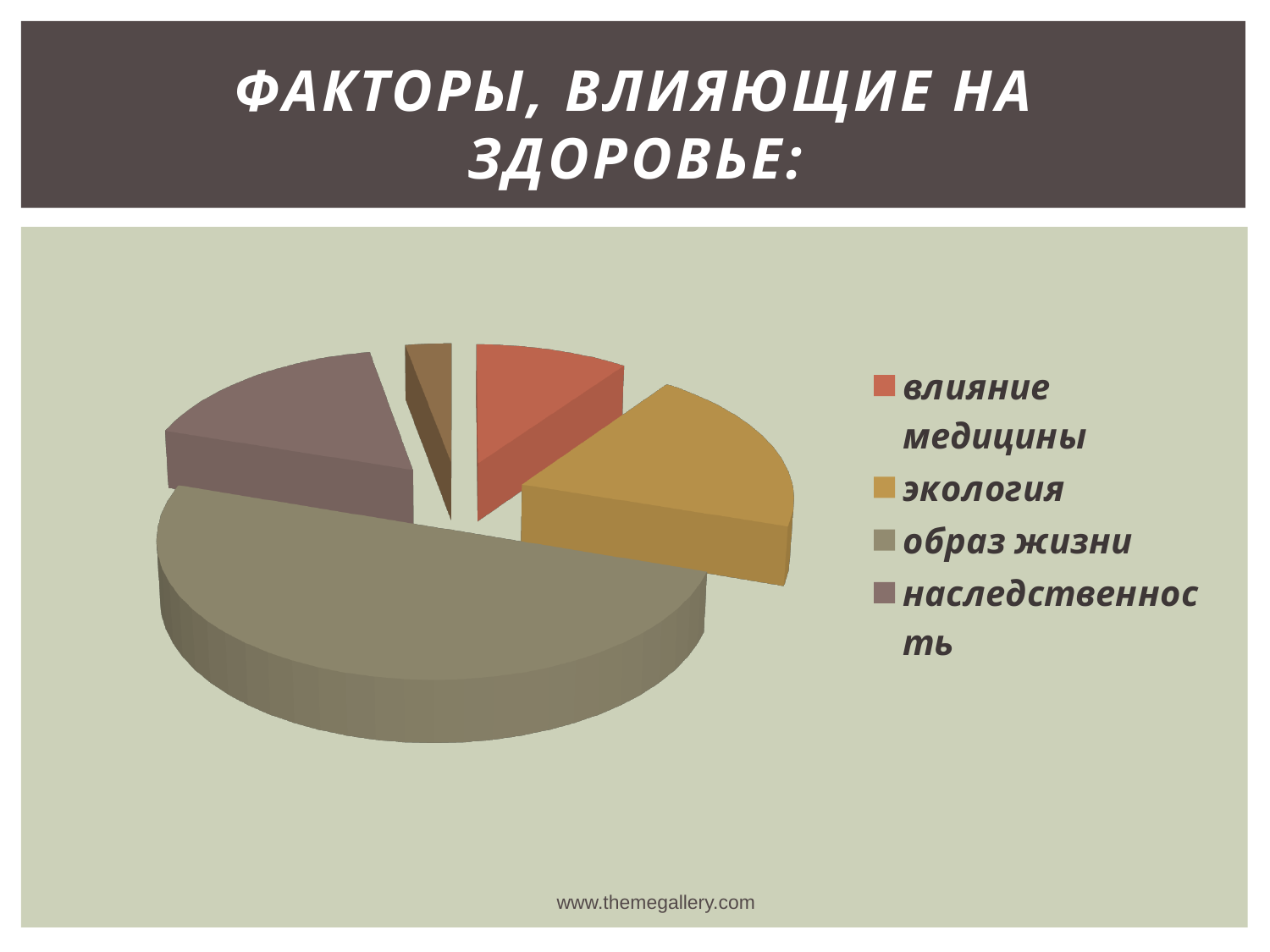
What is the title of the slide containing the pie chart? ФАКТОРЫ, ВЛИЯЮЩИЕ НА ЗДОРОВЬЕ: Which slice is larger, наследственность or влияние медицины? наследственность Which slice is larger, образ жизни or экология? образ жизни Which category has the largest slice of the pie chart? образ жизни Which legend entry is listed first in the pie chart's legend? влияние медицины Which slice is larger, экология or влияние медицины? экология What colour is the slice for влияние медицины in the pie chart? red How many entries does the legend of the pie chart list? 4 What kind of chart is shown on the slide? pie chart